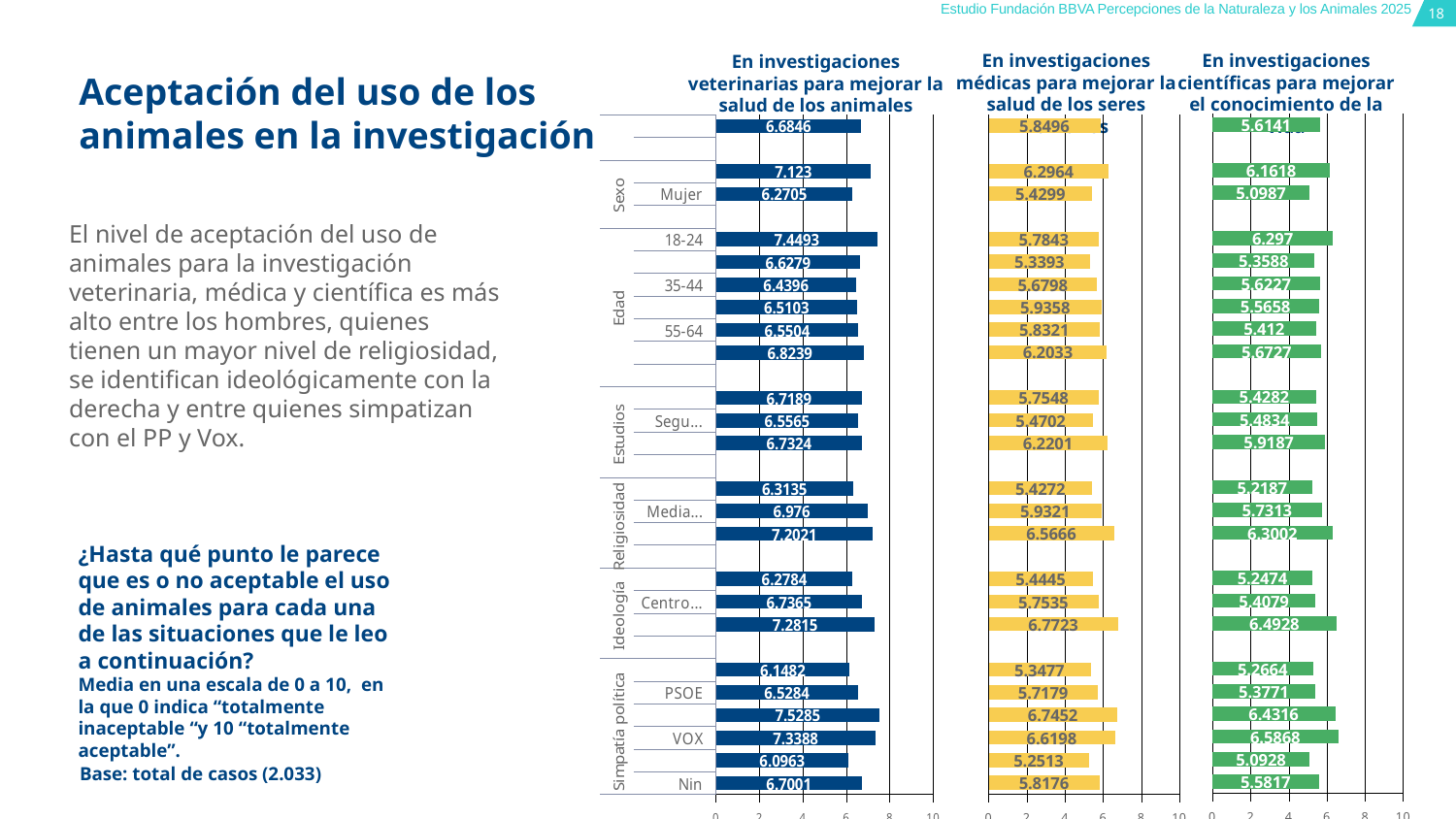
In the chart titled 'En investigaciones médicas para mejorar la salud de los seres', what is the value for 55-64? 5.8321 In the chart titled 'En investigaciones científicas para mejorar el conocimiento de la', what is the difference between the values for 18-24 and Mujer? 1.1983 In the chart titled 'En investigaciones veterinarias para mejorar la salud de los animales', what is the difference between the values for VOX and PSOE? 0.8104 In the chart titled 'En investigaciones científicas para mejorar el conocimiento de la', what is the value for 18-24? 6.297 In the chart titled 'En investigaciones veterinarias para mejorar la salud de los animales', which is larger, the value for 18-24 or for 35-44? 18-24 In the chart titled 'En investigaciones médicas para mejorar la salud de los seres', is the value for Mujer greater or less than 6? less In the chart titled 'En investigaciones veterinarias para mejorar la salud de los animales', what is the value for Mujer? 6.2705 In the chart titled 'En investigaciones científicas para mejorar el conocimiento de la', which is larger, the value for VOX or for PSOE? VOX In the chart titled 'En investigaciones veterinarias para mejorar la salud de los animales', what is the value for PSOE? 6.5284 What kind of chart is used on this slide? bar chart How many charts are shown on the slide? 3 In the chart titled 'En investigaciones médicas para mejorar la salud de los seres', what is the value for VOX? 6.6198